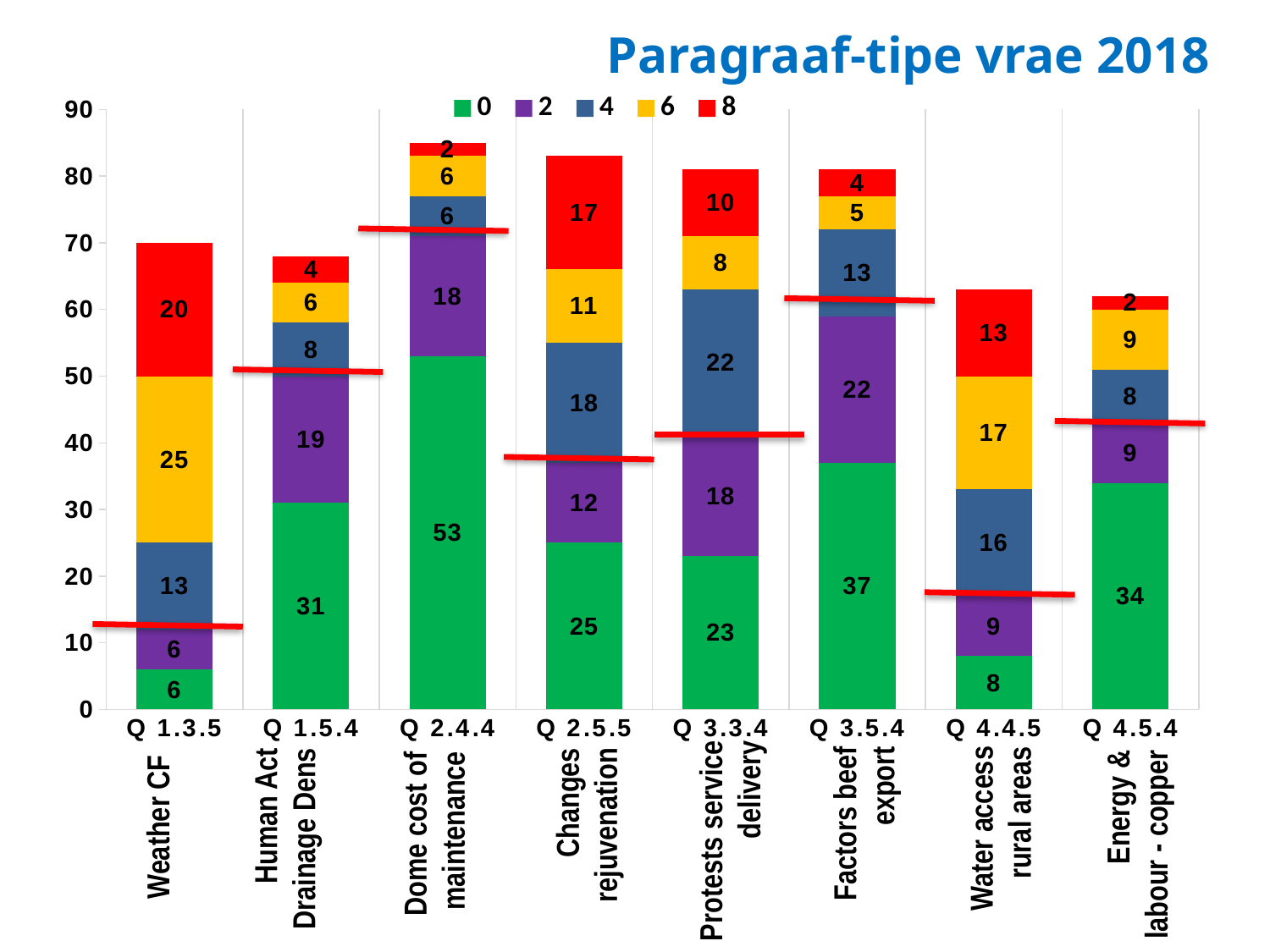
How many series does the legend list? 5 Which category has the smallest '0' series value? Q 1.3.5 Weather CF What is the difference between the '8' series values for Q 2.5.5 Changes rejuvenation and Q 3.3.4 Protests service delivery? 7 What is the value of the '8' series for Q 1.3.5 Weather CF? 20 What is the total of the stacked bar for Q 1.3.5 Weather CF? 70 What kind of chart is shown on the slide? Stacked bar chart How many question categories are plotted along the x axis? 8 What is the title of the chart? Paragraaf-tipe vrae 2018 Which category has the largest '0' series value? Q 2.4.4 Dome cost of maintenance What is the total of the stacked bar for Q 4.5.4 Energy & labour - copper? 62 What is the value of the '6' series for Q 4.4.5 Water access rural areas? 17 What is the value of the '0' series for Q 2.4.4 Dome cost of maintenance? 53